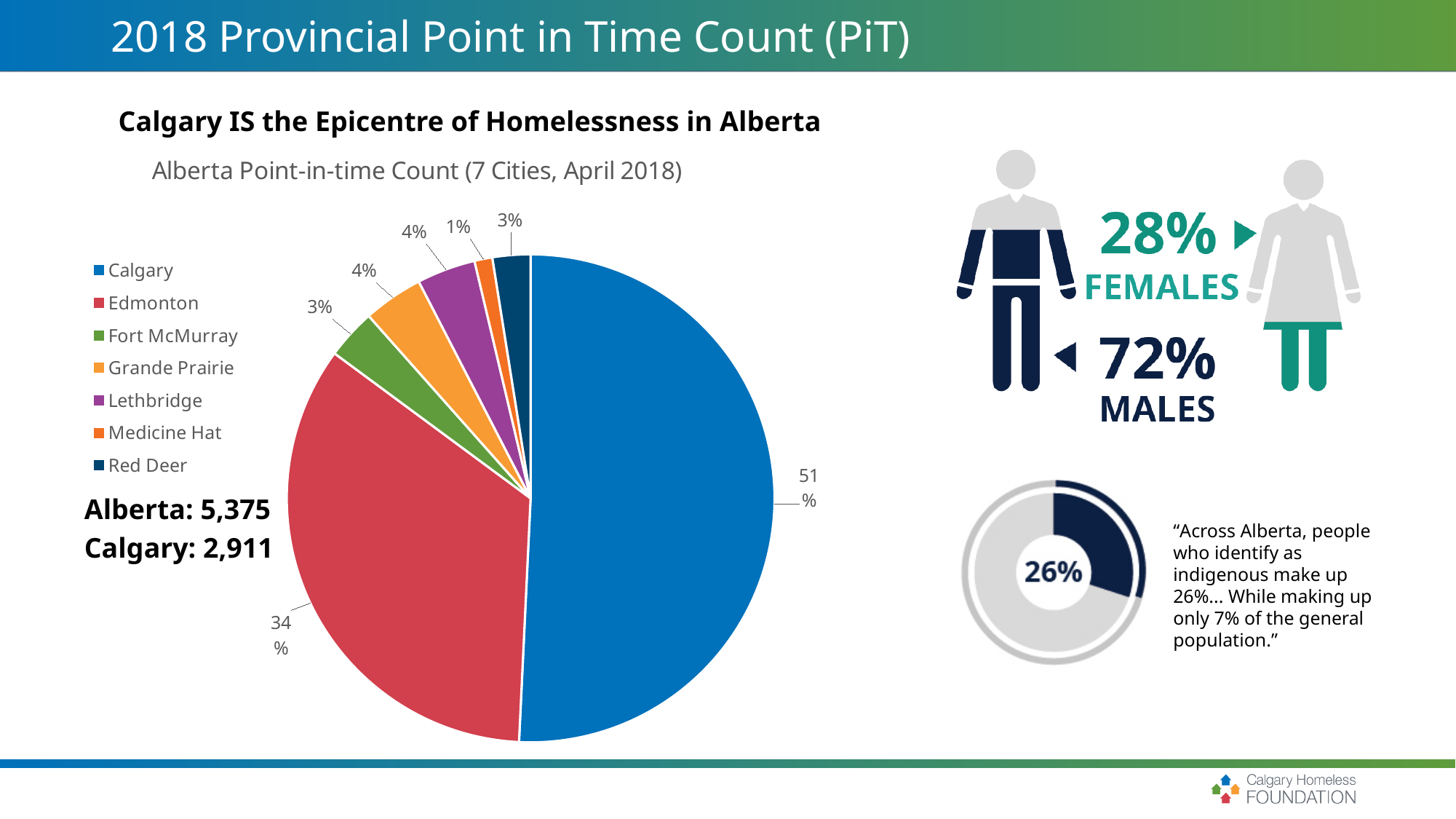
What kind of chart is 'Alberta Point-in-time Count (7 Cities, April 2018)'? Pie chart In the pie chart 'Alberta Point-in-time Count (7 Cities, April 2018)', which colour represents Edmonton in the legend? Red In the pie chart 'Alberta Point-in-time Count (7 Cities, April 2018)', what share does Lethbridge have? 4% In the pie chart 'Alberta Point-in-time Count (7 Cities, April 2018)', what share does Edmonton have? 34% In the pie chart 'Alberta Point-in-time Count (7 Cities, April 2018)', how many percentage points larger is Calgary's share than Edmonton's? 17% In the pie chart 'Alberta Point-in-time Count (7 Cities, April 2018)', which city has the largest slice? Calgary In the pie chart 'Alberta Point-in-time Count (7 Cities, April 2018)', which city has the smallest slice? Medicine Hat How many cities are shown in the pie chart 'Alberta Point-in-time Count (7 Cities, April 2018)'? 7 In the pie chart 'Alberta Point-in-time Count (7 Cities, April 2018)', which has the larger share, Edmonton or Fort McMurray? Edmonton What percentage is shown in the donut chart on the lower right of the slide? 26% In the pie chart 'Alberta Point-in-time Count (7 Cities, April 2018)', what share does Calgary have? 51% In the pie chart 'Alberta Point-in-time Count (7 Cities, April 2018)', what share does Medicine Hat have? 1%